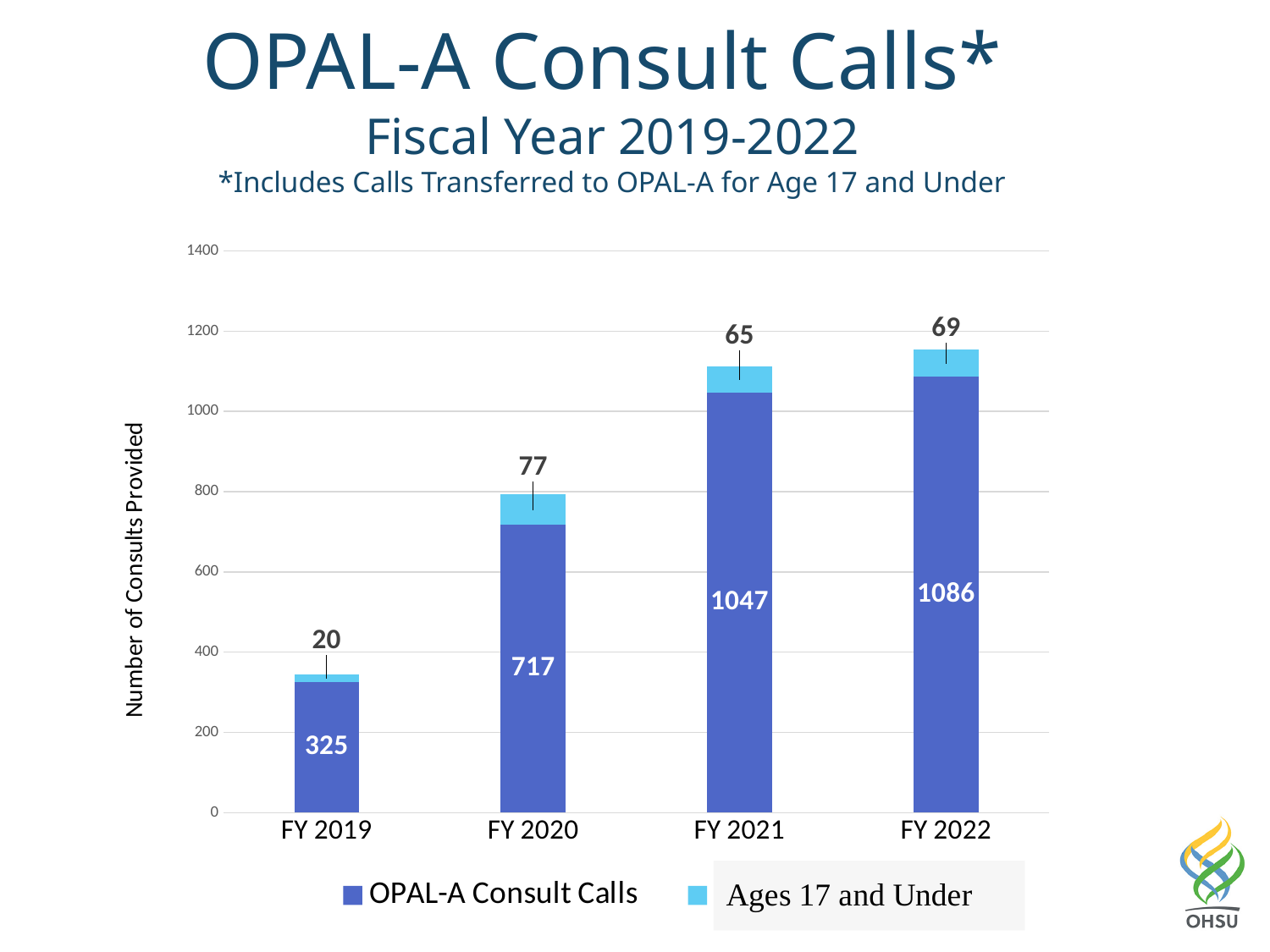
Which is larger, the Ages 17 and Under value for FY 2020 or for FY 2022? FY 2020 How many series does the legend list? 2 Is the total height of the FY 2020 stacked bar greater or less than 600? greater How many fiscal years are shown on the x axis? 4 What is the value for OPAL-A Consult Calls in FY 2021? 1047 Which fiscal year has the highest value for OPAL-A Consult Calls? FY 2022 What is the value for Ages 17 and Under in FY 2020? 77 What is the total of the FY 2019 stacked bar? 345 Which fiscal year has the lowest value for Ages 17 and Under? FY 2019 What is the difference between the OPAL-A Consult Calls values for FY 2022 and FY 2021? 39 What kind of chart is shown on the slide? stacked bar chart Do the OPAL-A Consult Calls values rise or fall from FY 2019 to FY 2022? rise